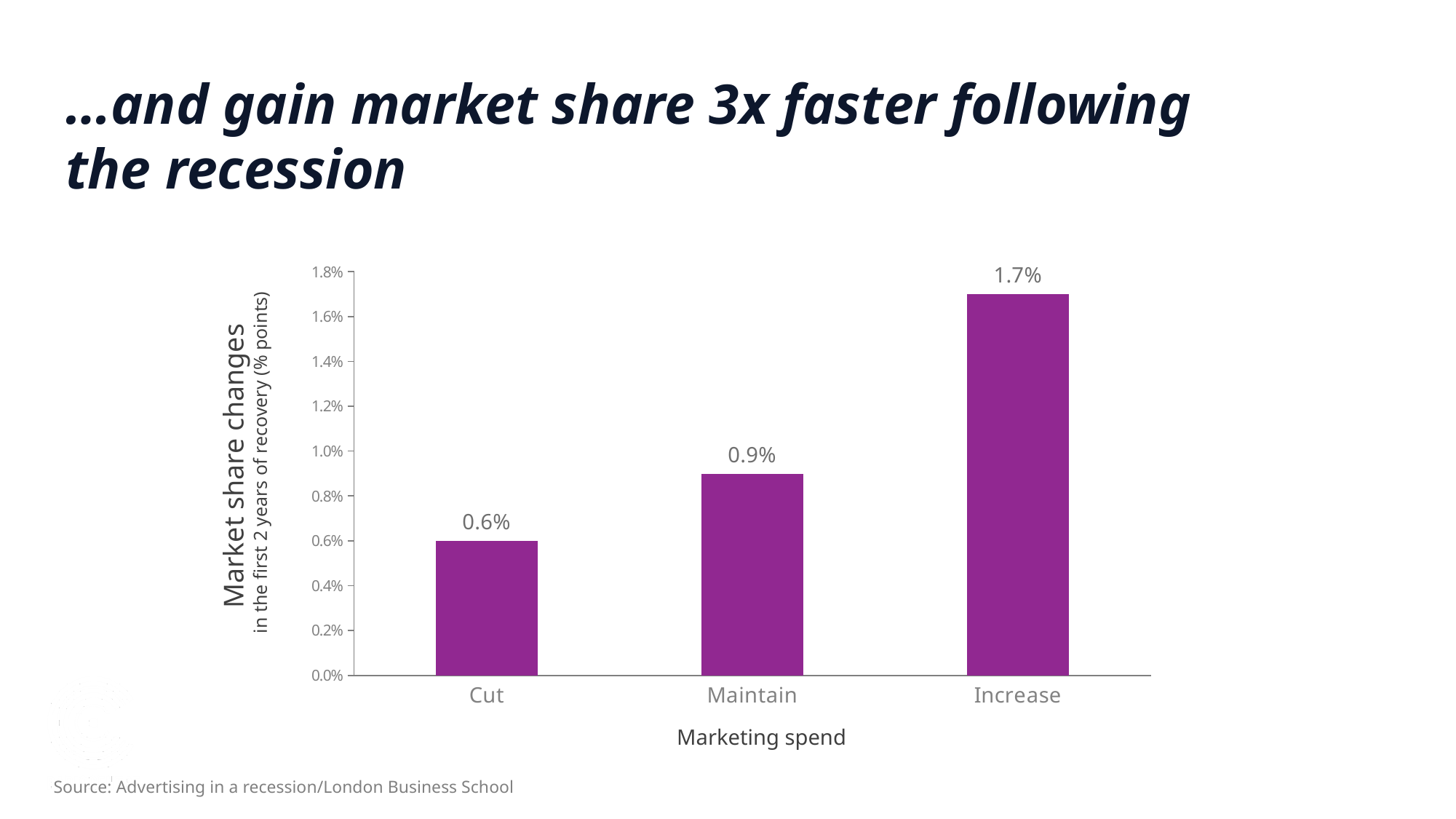
What is the label of the x axis? Marketing spend What kind of chart is shown on the slide? Bar chart Is the value for Increase greater or less than 1.0%? greater What is the market share change for companies that Increase marketing spend? 1.7% What is the market share change for companies that Cut marketing spend? 0.6% Which marketing spend category has the lowest market share change? Cut What is the market share change for companies that Maintain marketing spend? 0.9% What is the difference in market share change between Increase and Cut? 1.1% Which marketing spend category has the highest market share change? Increase How many marketing spend categories are shown on the chart? 3 What is the difference in market share change between Maintain and Cut? 0.3% Which has a larger market share change, Maintain or Increase? Increase